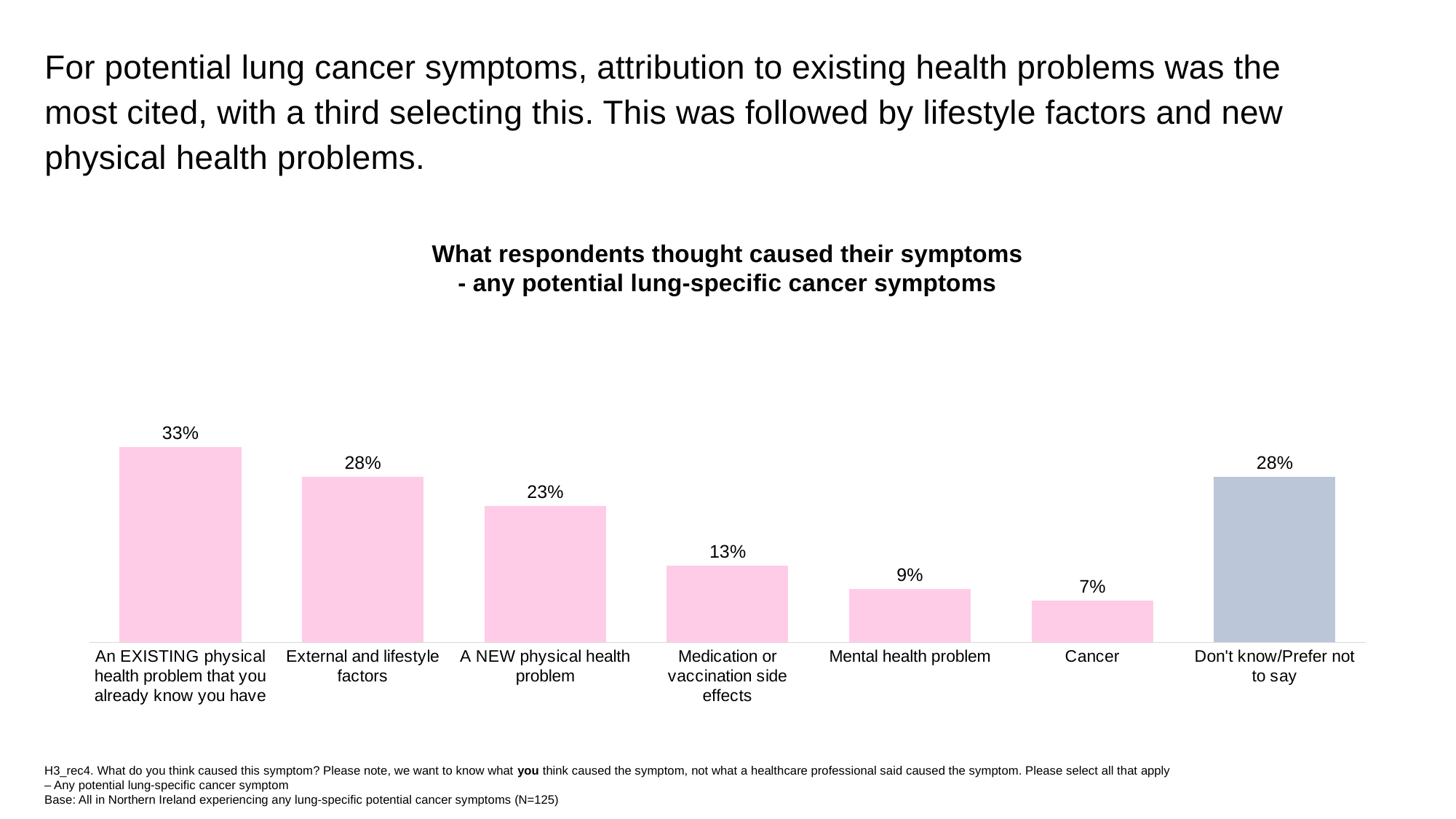
What is the difference between 'Mental health problem' and 'Cancer'? 2 percentage points What is the value for 'Cancer'? 7% What percentage of respondents attributed their symptoms to an existing physical health problem that they already know they have? 33% What type of chart is shown on the slide? Bar chart Which bar is shown in a different colour (grey-blue) from the others? Don't know/Prefer not to say What is the difference between 'External and lifestyle factors' and 'A NEW physical health problem'? 5 percentage points Which category has the lowest value? Cancer Which is larger: 'A NEW physical health problem' or 'Medication or vaccination side effects'? A NEW physical health problem How many categories are shown in the chart? 7 Which category has the highest value? An EXISTING physical health problem that you already know you have What percentage selected 'Medication or vaccination side effects'? 13% What is the value for 'Don't know/Prefer not to say'? 28%